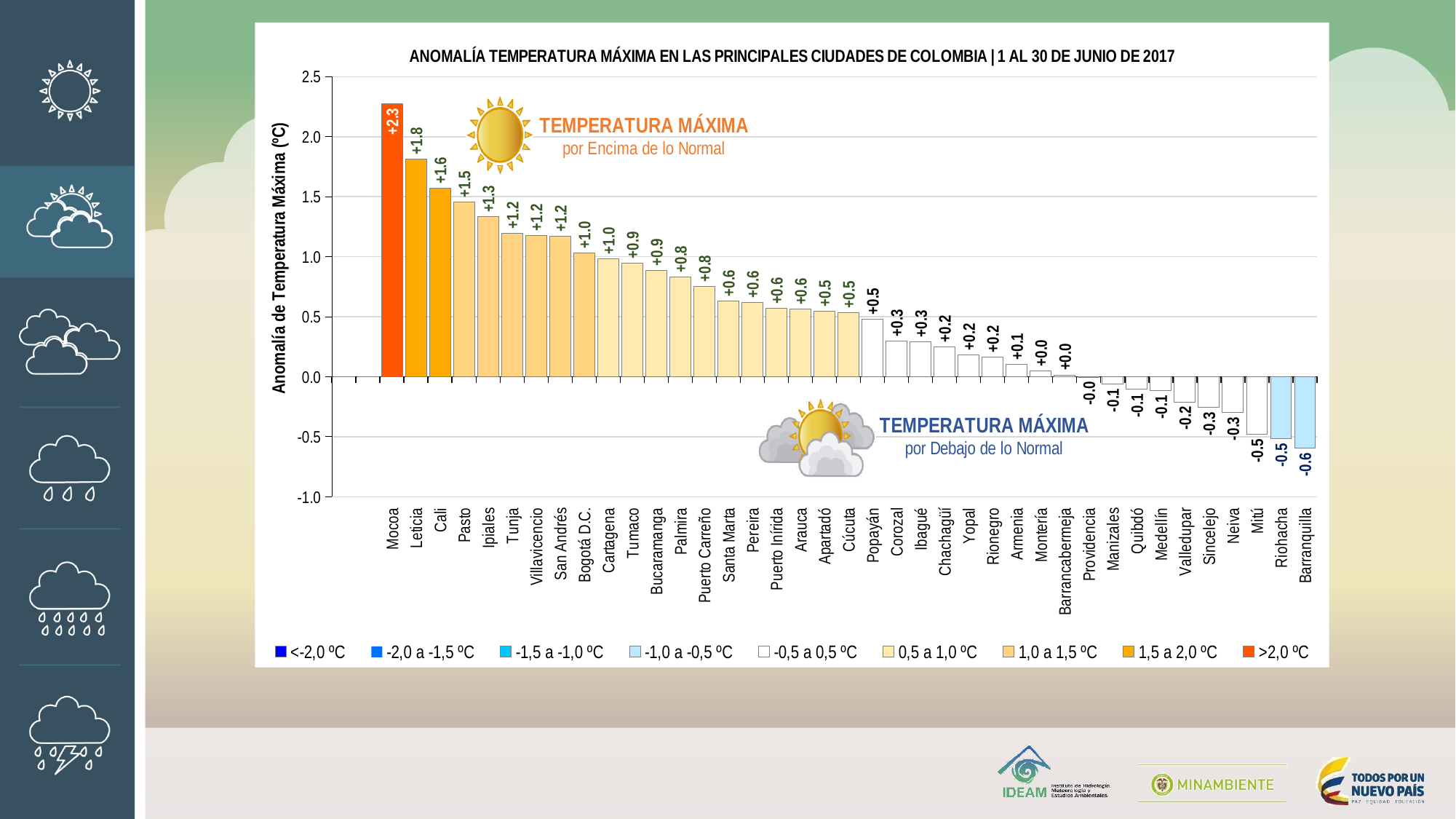
What kind of chart is shown on the slide? bar chart How many cities are shown on the x axis of the chart? 39 How many categories does the legend below the chart list? 9 Which city has the highest maximum temperature anomaly? Mocoa Do the values rise or fall moving from left to right along the x axis? fall Is the value for Mocoa greater or less than 2.0? greater What is the value shown for Bogotá D.C.? +1.0 What is the difference between the anomaly for Mocoa and the anomaly for Leticia? 0.5 What is the maximum temperature anomaly shown for Mocoa? +2.3 What is the maximum temperature anomaly shown for Barranquilla? -0.6 Which city has the larger anomaly, Cali or Pasto? Cali Which city has the lowest maximum temperature anomaly? Barranquilla